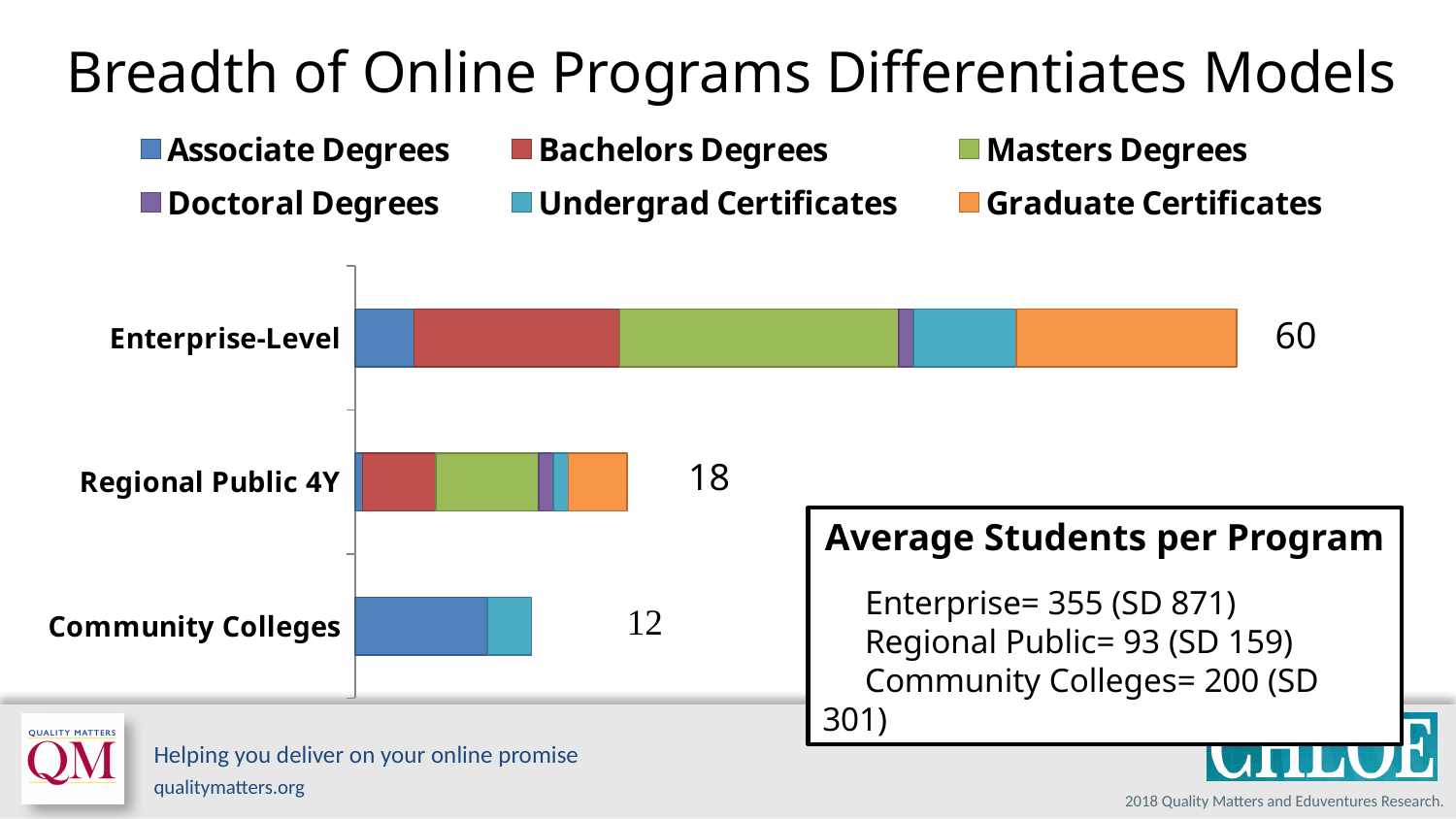
What is the total value labeled for the Enterprise-Level bar? 60 What is the total value labeled for the Community Colleges bar? 12 How many institution categories are plotted on the chart? 3 How many series does the legend list? 6 What kind of chart is shown on the slide? Stacked bar chart What is the total value labeled for the Regional Public 4Y bar? 18 Which legend series is shown in orange? Graduate Certificates Which has a larger total, Regional Public 4Y or Community Colleges? Regional Public 4Y What is the difference between the Regional Public 4Y total and the Community Colleges total? 6 What is the difference between the Enterprise-Level total and the Regional Public 4Y total? 42 Which category has the lowest total number of online programs? Community Colleges Which category has the highest total number of online programs? Enterprise-Level